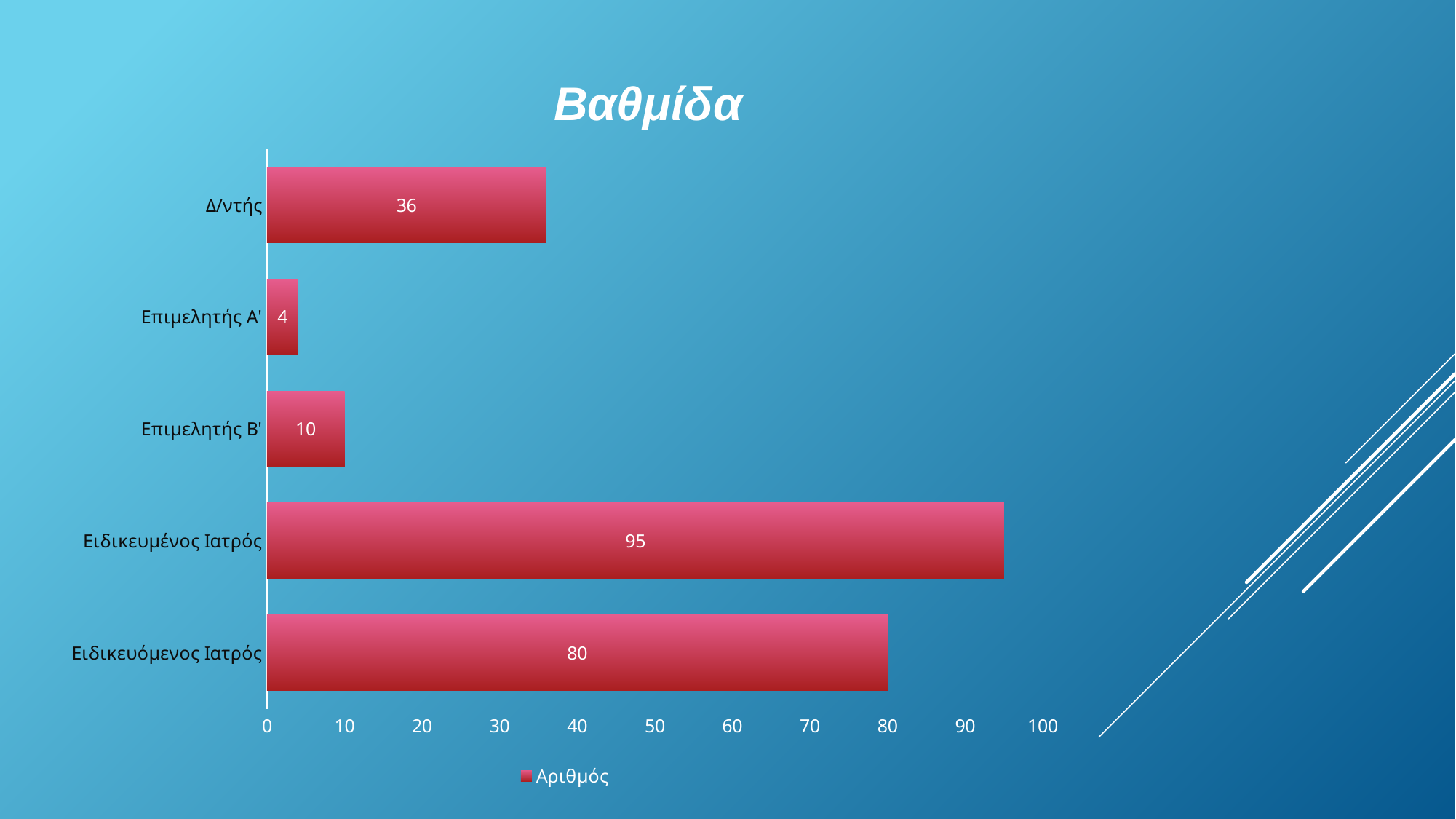
How many series does the legend list? 1 How many categories are shown in the chart? 5 Which is larger, the value for Επιμελητής Α' or the value for Επιμελητής Β'? Επιμελητής Β' What is the difference between the values for Ειδικευμένος Ιατρός and Ειδικευόμενος Ιατρός? 15 What kind of chart is shown on the slide? bar chart Which category has the highest value? Ειδικευμένος Ιατρός What is the title of the chart? Βαθμίδα What is the value for Δ/ντής? 36 Which category has the lowest value? Επιμελητής Α' What is the value for Ειδικευμένος Ιατρός? 95 What is the difference between the values for Δ/ντής and Επιμελητής Β'? 26 What is the value for Επιμελητής Β'? 10